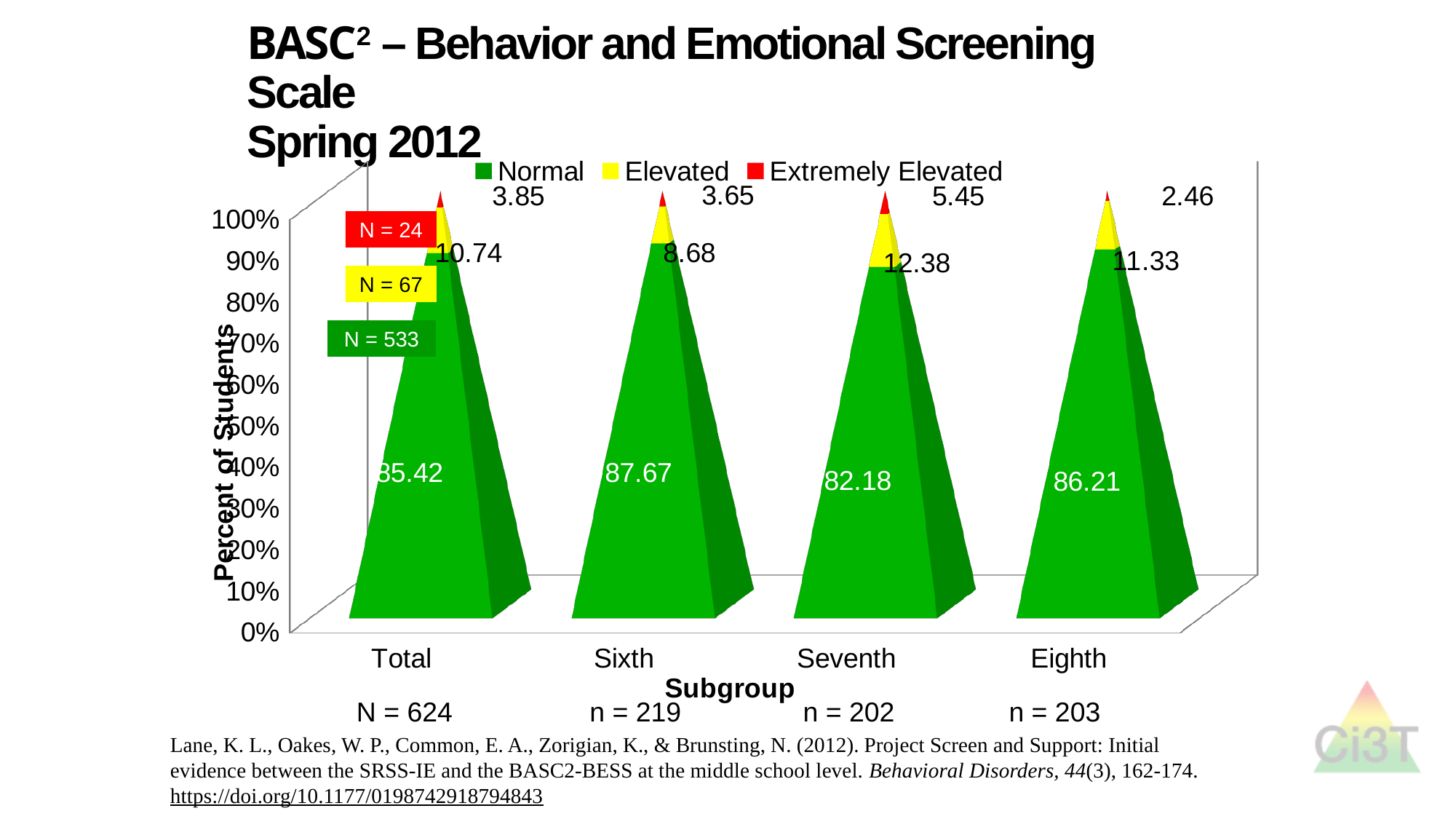
How many series does the legend list? 3 What is the Normal value for the Sixth subgroup? 87.67 What is the label of the y axis? Percent of Students Which subgroup has the lowest Extremely Elevated value? Eighth How many subgroups are shown on the x axis? 4 What is the difference between the Elevated values for Seventh and Sixth? 3.7 Which subgroup has the highest Normal value? Sixth What is the Elevated value for the Seventh subgroup? 12.38 Which is larger, the Normal value for Eighth or the Normal value for Seventh? Eighth What is the Normal value for the Total subgroup? 85.42 What is the Extremely Elevated value for the Eighth subgroup? 2.46 What kind of chart is shown on the slide? Stacked bar chart